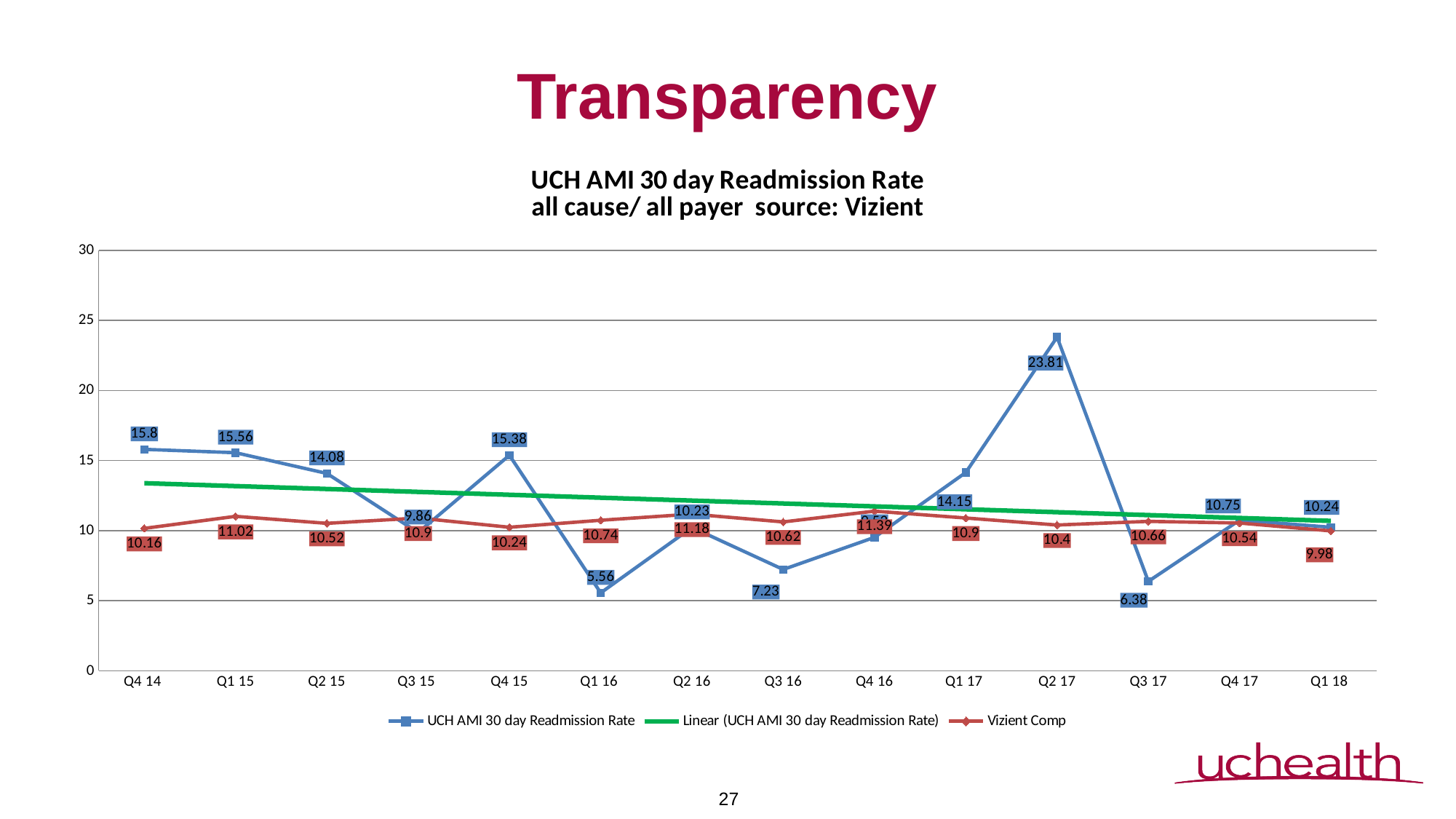
What is the UCH AMI 30 day Readmission Rate for Q4 14? 15.8 In Q1 16, which is larger: the UCH AMI 30 day Readmission Rate or the Vizient Comp value? Vizient Comp What is the UCH AMI 30 day Readmission Rate for Q2 17? 23.81 What is the difference between the UCH AMI 30 day Readmission Rate and the Vizient Comp value in Q2 17? 13.41 How many quarters are shown on the x axis? 14 In which quarter is the UCH AMI 30 day Readmission Rate lowest? Q1 16 Is the UCH AMI 30 day Readmission Rate for Q2 17 greater or less than 20? greater What kind of chart is shown on the slide? line chart In which quarter is the Vizient Comp value highest? Q4 16 What is the Vizient Comp value for Q1 18? 9.98 How many series does the legend list? 3 In which quarter is the UCH AMI 30 day Readmission Rate highest? Q2 17